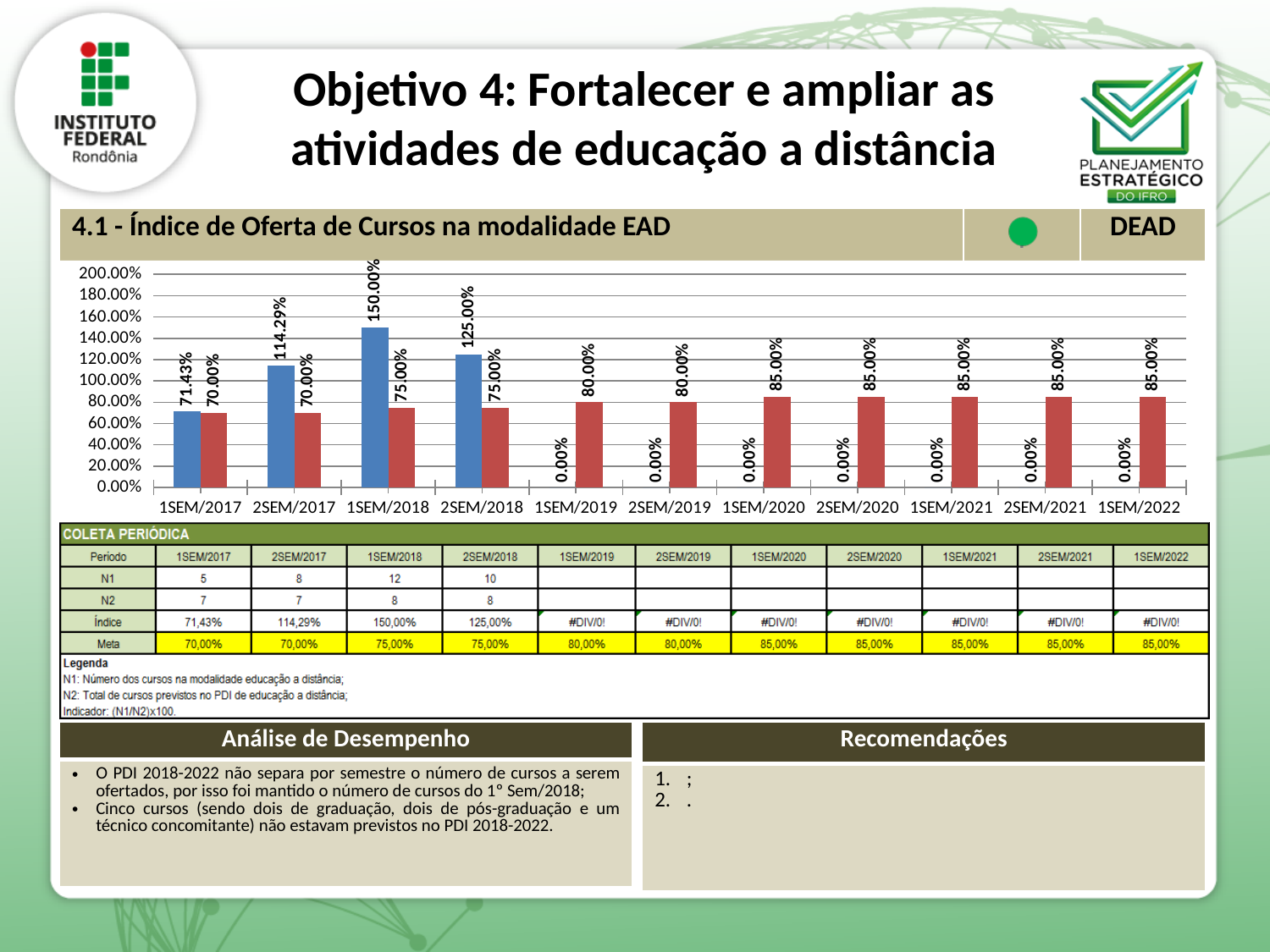
What is the value of the blue bar for 1SEM/2018? 150.00% What is the difference between the blue bar and the red bar for 2SEM/2018? 50.00% What is the value of the blue bar for 2SEM/2017? 114.29% Which period has the highest blue bar? 1SEM/2018 What type of chart is shown on the slide? bar chart How many periods (categories) are shown on the x axis of the chart? 11 Do the red bars rise or fall from 1SEM/2017 to 1SEM/2022? rise What is the value of the red bar for 1SEM/2017? 70.00% What is the title of the indicator shown above the chart? 4.1 - Índice de Oferta de Cursos na modalidade EAD Is the value of the blue bar for 2SEM/2017 greater or less than 100.00%? greater What is the value of the red bar for 1SEM/2022? 85.00% Which is larger for 1SEM/2017, the blue bar or the red bar? the blue bar